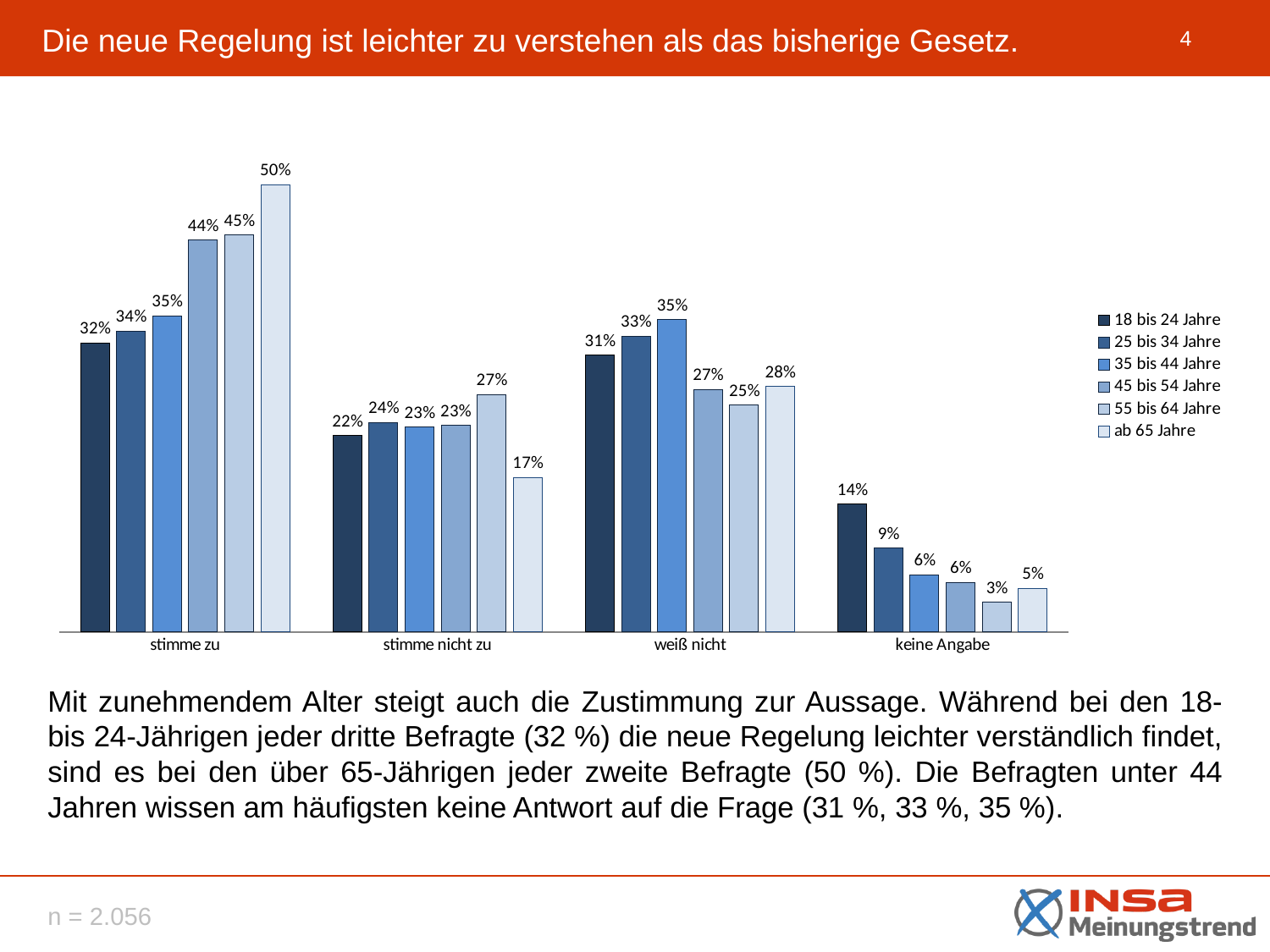
Which age group has the lowest value in the "keine Angabe" category? 55 bis 64 Jahre In the "stimme nicht zu" category, which is larger: the value for "25 bis 34 Jahre" or for "ab 65 Jahre"? 25 bis 34 Jahre Which age group has the highest value in the "weiß nicht" category? 35 bis 44 Jahre What kind of chart is shown on the slide? bar chart What is the value for "ab 65 Jahre" in the "stimme zu" category? 50% What is the value for "18 bis 24 Jahre" in the "keine Angabe" category? 14% How many categories are shown on the x axis? 4 Do the values for "stimme zu" rise or fall as the age groups get older? rise What is the first entry listed in the legend? 18 bis 24 Jahre What is the difference between the "ab 65 Jahre" and "18 bis 24 Jahre" values in the "stimme zu" category? 18% How many series does the legend list? 6 What is the value for "55 bis 64 Jahre" in the "stimme nicht zu" category? 27%